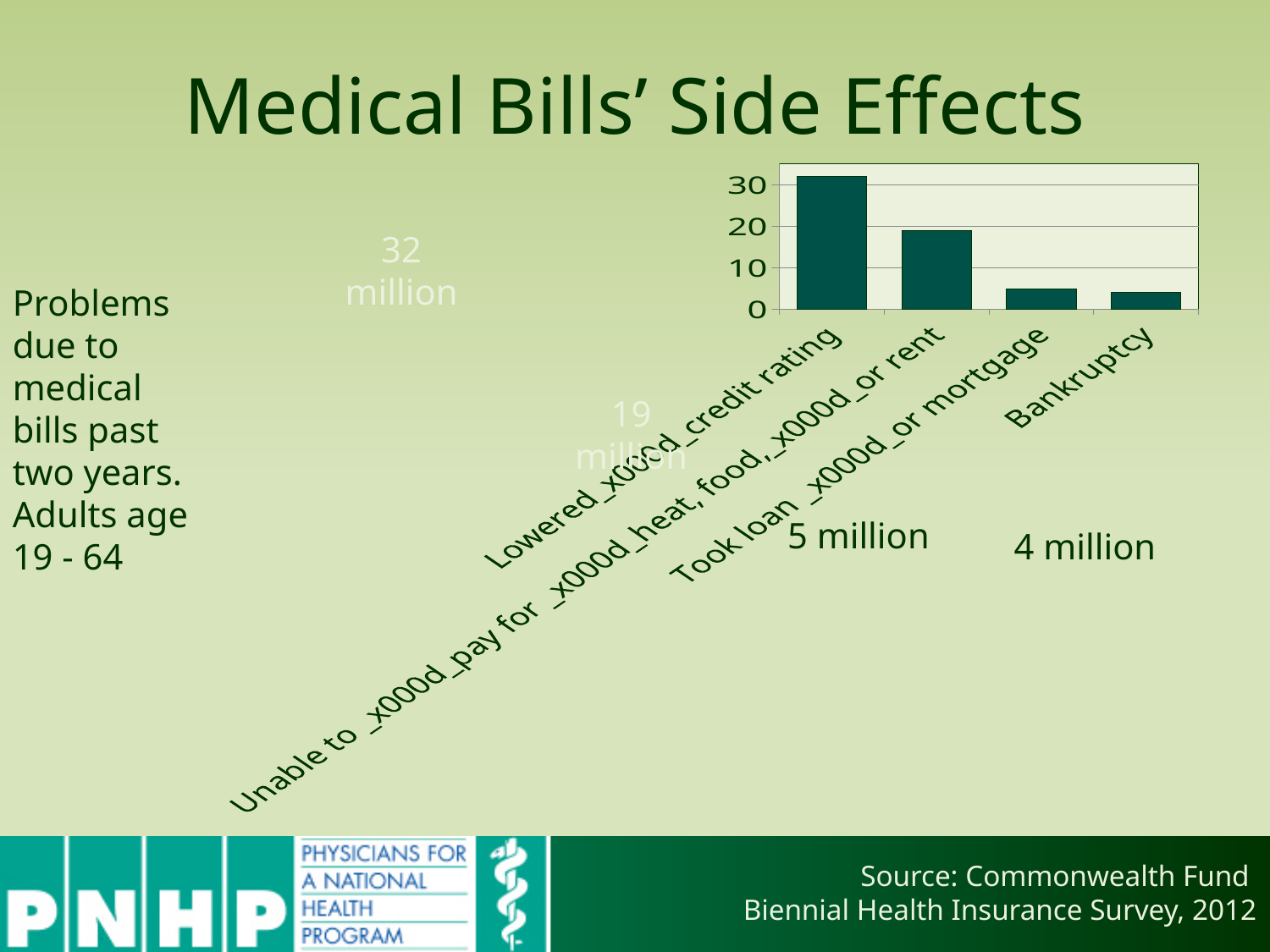
Which is larger, the value for Lowered credit rating or the value for Took loan or mortgage? Lowered credit rating Which category has the highest value? Lowered credit rating What is the value shown for Lowered credit rating? 32 million What is the difference between the values for Unable to pay for heat, food, or rent and Lowered credit rating? 13 million What is the value shown for Bankruptcy? 4 million Is the value for Lowered credit rating greater or less than 10? greater What kind of chart is shown on the slide? bar chart How many categories does the chart show? 4 Do the values rise or fall from left to right across the categories? fall Which category has the lowest value? Bankruptcy What is the value shown for Unable to pay for heat, food, or rent? 19 million What is the value shown for Took loan or mortgage? 5 million